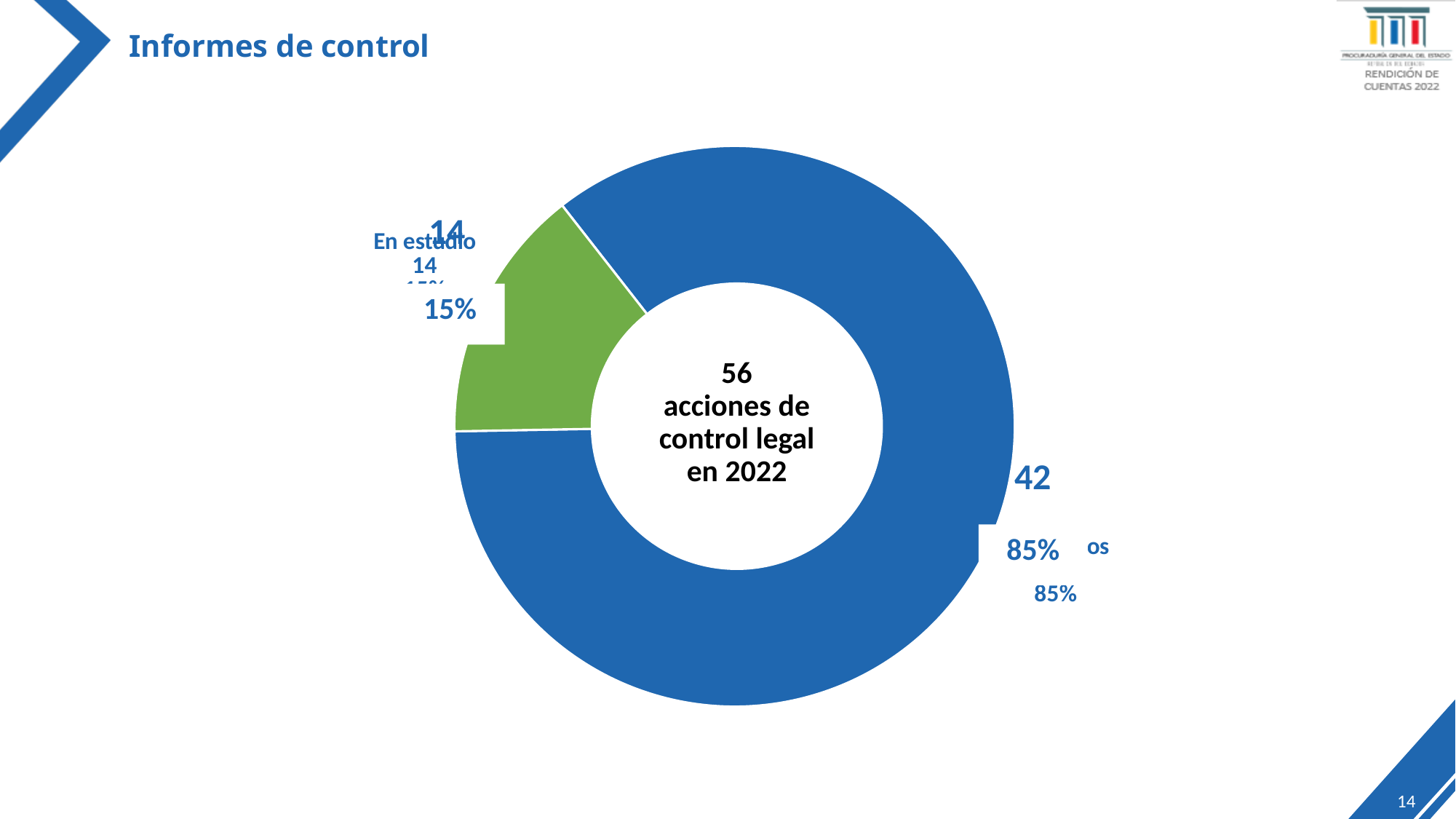
What total number of 'acciones de control legal en 2022' is shown in the centre of the chart? 56 What colour is the 'En estudio' slice? green What percentage share does the 'En estudio' slice represent? 15% What is the value shown for the large blue slice? 42 What kind of chart is shown on the slide? donut (pie) chart What is the difference between the value of the blue slice (42) and the 'En estudio' slice (14)? 28 Which slice is the largest in the chart, the green 'En estudio' slice or the blue slice? the blue slice What is the value shown for the 'En estudio' slice? 14 What percentage share does the large blue slice represent? 85% How many slices does the donut chart have? 2 What is the title of the slide containing the chart? Informes de control Which slice is the smallest in the chart? En estudio